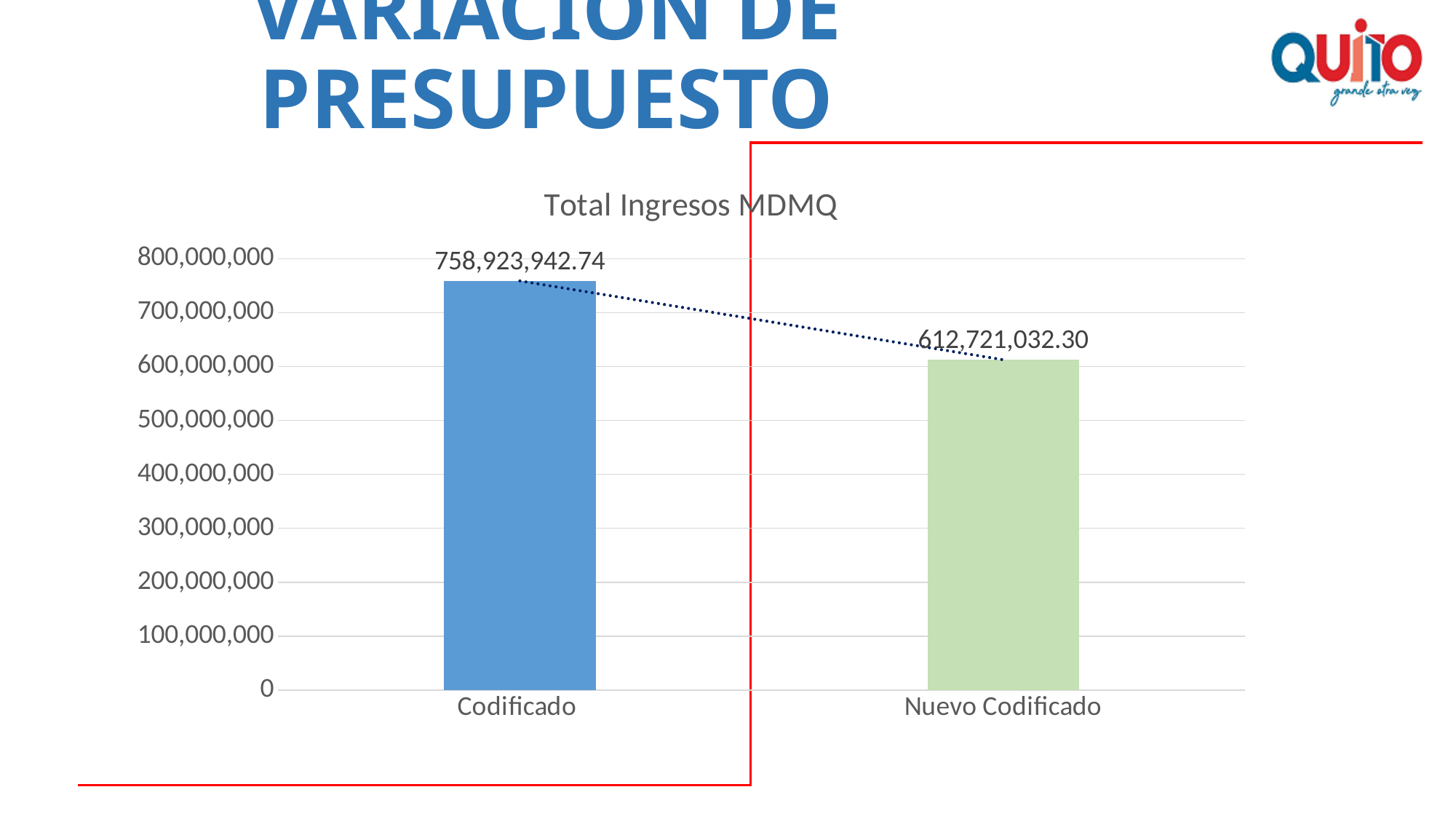
Is the value for Nuevo Codificado greater or less than 700,000,000? less How many categories are shown in the Total Ingresos MDMQ chart? 2 Is the value for Codificado greater or less than 700,000,000? greater What is the title of the chart on the slide? Total Ingresos MDMQ What kind of chart is shown on the slide? bar chart What is the value for Codificado in the Total Ingresos MDMQ chart? 758,923,942.74 What is the value for Nuevo Codificado in the Total Ingresos MDMQ chart? 612,721,032.30 Do the values rise or fall from Codificado to Nuevo Codificado? fall Which is larger in the Total Ingresos MDMQ chart, Codificado or Nuevo Codificado? Codificado Which category has the lowest value in the Total Ingresos MDMQ chart? Nuevo Codificado What is the difference between the Codificado and Nuevo Codificado values in the Total Ingresos MDMQ chart? 146,202,910.44 Which category has the highest value in the Total Ingresos MDMQ chart? Codificado